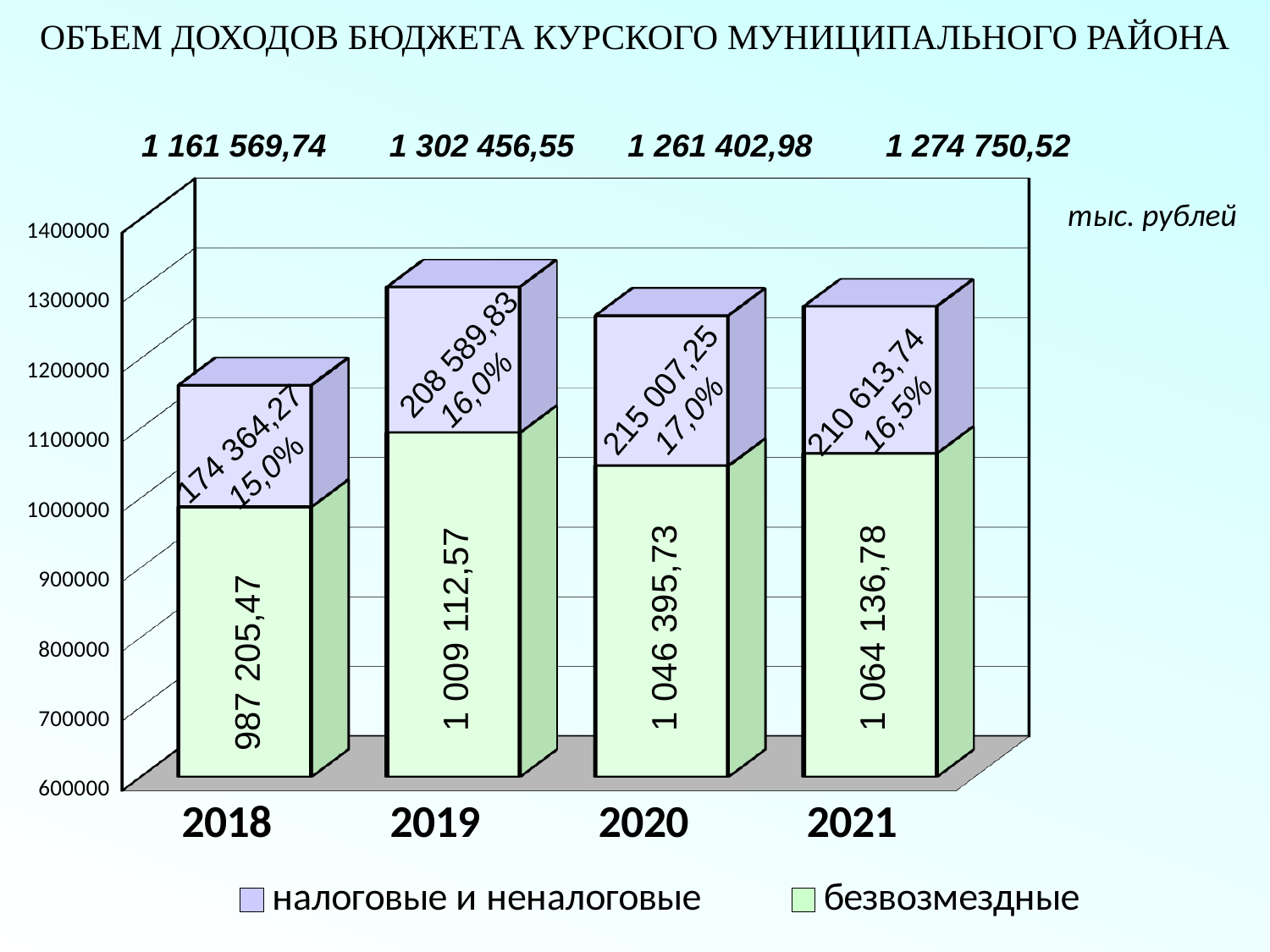
What percentage share is shown for налоговые и неналоговые in 2021? 16,5% What type of chart is shown on the slide? bar chart How many years (categories) are shown on the x axis? 4 What unit of measurement is indicated on the chart? тыс. рублей What is the difference between безвозмездные in 2021 and in 2020? 17 741,05 Which year has the highest total budget income? 2019 What is the value of налоговые и неналоговые for 2020? 215 007,25 What is the value of безвозмездные for 2018? 987 205,47 How many series does the legend list? 2 Which year has the lowest value for безвозмездные? 2018 What is the total budget income shown for 2019? 1 302 456,55 Which is larger: налоговые и неналоговые in 2019 or in 2020? 2020